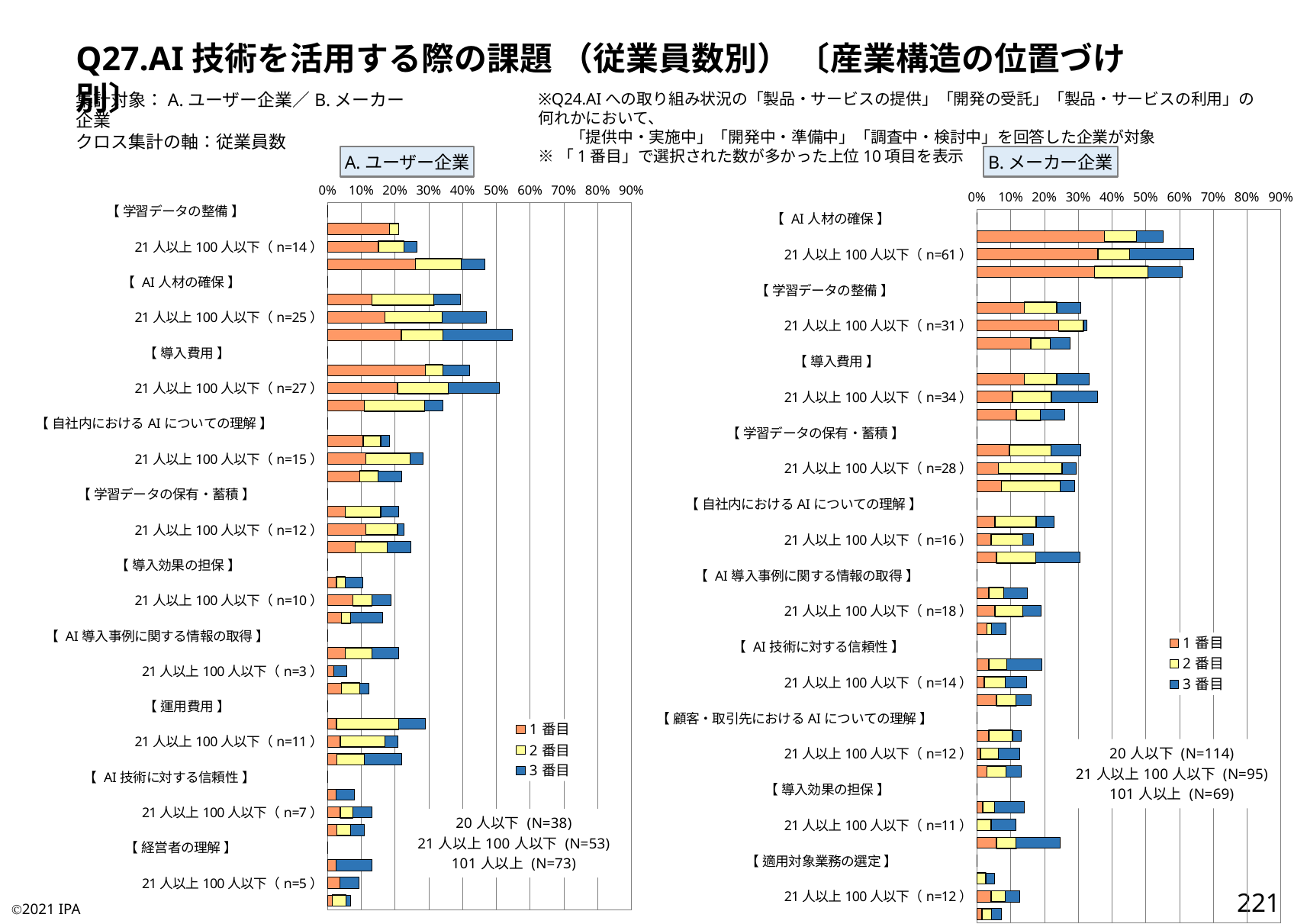
In the B. メーカー企業 chart, is the total for AI人材の確保 (21人以上100人以下, n=61) greater or less than 60%? greater In the B. メーカー企業 chart, which is larger: the 20人以下 bar for AI人材の確保 or the 20人以下 bar for 学習データの整備? AI人材の確保 How many challenge categories are shown in the B. メーカー企業 chart? 10 What kind of chart is the A. ユーザー企業 chart? Stacked bar chart What is the title shown above the left chart? A. ユーザー企業 How many series does the legend of the B. メーカー企業 chart list? 3 In the B. メーカー企業 chart, which category has the longest stacked bar? AI人材の確保 In the A. ユーザー企業 chart, is the total for the 101人以上 bar of 経営者の理解 greater or less than 10%? less In the A. ユーザー企業 chart, is the total for the 101人以上 bar of 学習データの整備 greater or less than 50%? less What are the legend entries of the A. ユーザー企業 chart? 1番目, 2番目, 3番目 In the A. ユーザー企業 chart, which category has the longest stacked bar? AI人材の確保